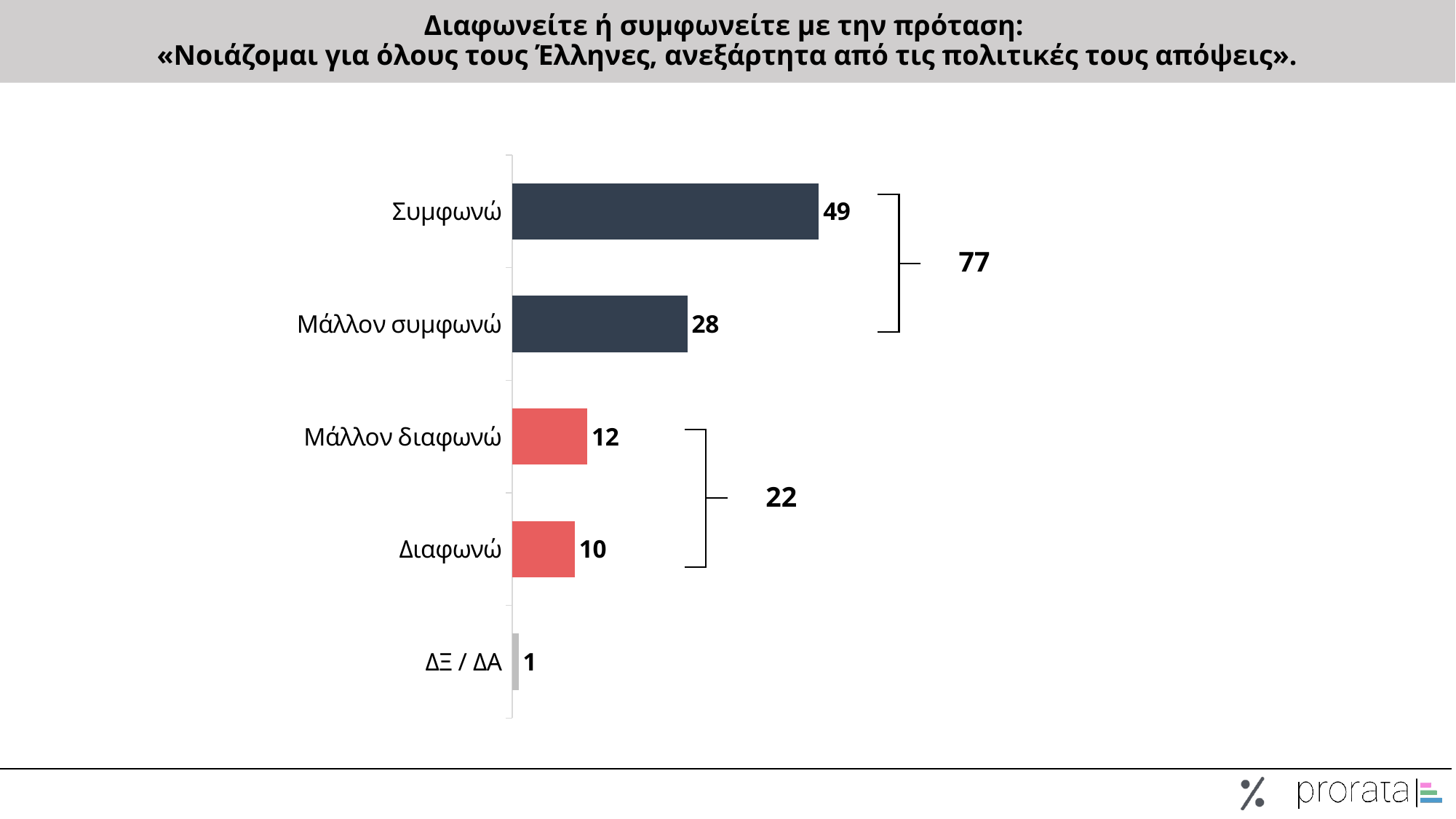
Which category has the highest value? Συμφωνώ What is the value for ΔΞ / ΔΑ? 1 Which category has the lowest value? ΔΞ / ΔΑ What is the value for Διαφωνώ? 10 What is the value for Μάλλον διαφωνώ? 12 What kind of chart is shown on the slide? Bar chart What is the value for Μάλλον συμφωνώ? 28 What combined total is shown by the bracket grouping Συμφωνώ and Μάλλον συμφωνώ? 77 What is the value for Συμφωνώ? 49 How many categories are shown in the chart? 5 Which is larger, the value for Μάλλον διαφωνώ or the value for Διαφωνώ? Μάλλον διαφωνώ What is the difference between the values for Συμφωνώ and Μάλλον συμφωνώ? 21